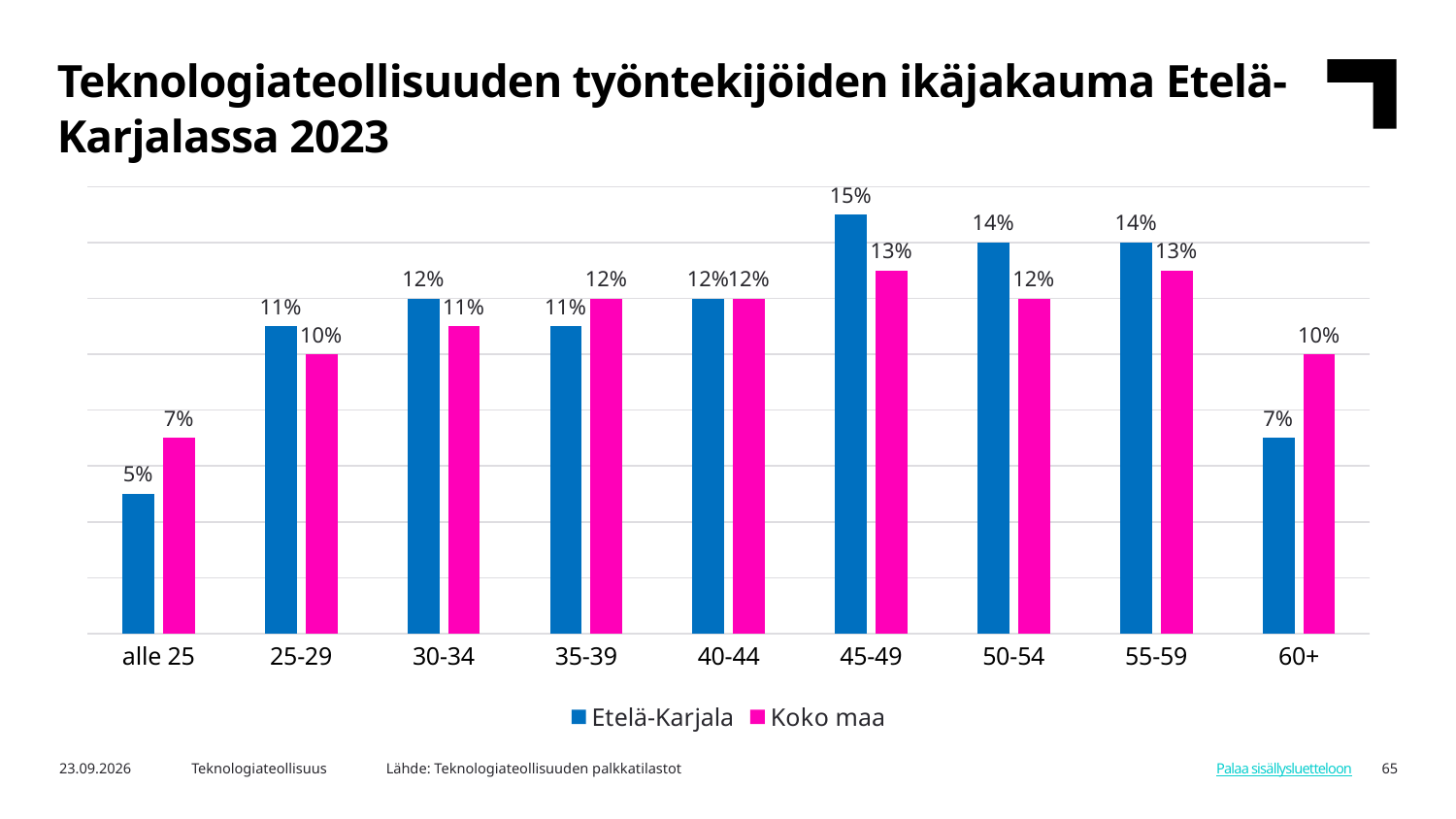
Which colour represents the Koko maa series? Pink In the 60+ age group, which series has the larger value, Etelä-Karjala or Koko maa? Koko maa What is the difference between the Etelä-Karjala and Koko maa values in the 50-54 age group? 2 percentage points What is the value for Etelä-Karjala in the alle 25 age group? 5% What is the value for Koko maa in the 60+ age group? 10% What kind of chart is shown on the slide? Bar chart How many age groups are shown on the x axis? 9 Which age group has the highest value for Etelä-Karjala? 45-49 What is the value for Koko maa in the 25-29 age group? 10% What is the value for Etelä-Karjala in the 45-49 age group? 15% Which age group has the lowest value for Koko maa? alle 25 How many series does the legend list? 2